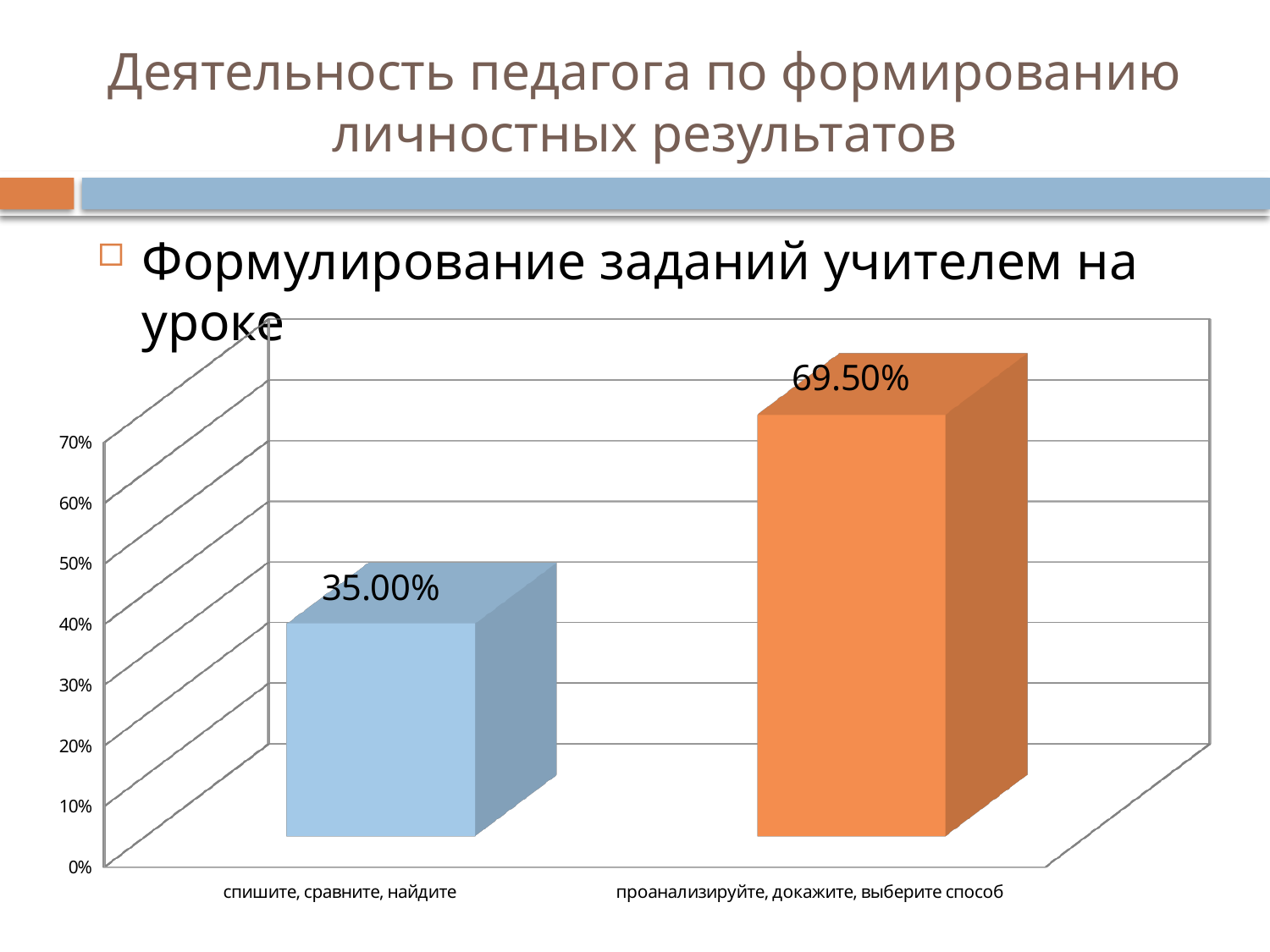
What is the value for "спишите, сравните, найдите"? 35.00% Which is larger: the value for "спишите, сравните, найдите" or the value for "проанализируйте, докажите, выберите способ"? проанализируйте, докажите, выберите способ What kind of chart is shown on the slide? bar chart What colour is the bar for "проанализируйте, докажите, выберите способ"? orange What is the highest value shown on the vertical axis? 70% What is the value for "проанализируйте, докажите, выберите способ"? 69.50% Which category has the lowest value? спишите, сравните, найдите Which category has the highest value? проанализируйте, докажите, выберите способ How many categories are shown in the chart? 2 Is the value for "проанализируйте, докажите, выберите способ" greater or less than 60%? greater Is the value for "спишите, сравните, найдите" greater or less than 50%? less What is the difference between the values for "проанализируйте, докажите, выберите способ" and "спишите, сравните, найдите"? 34.50%